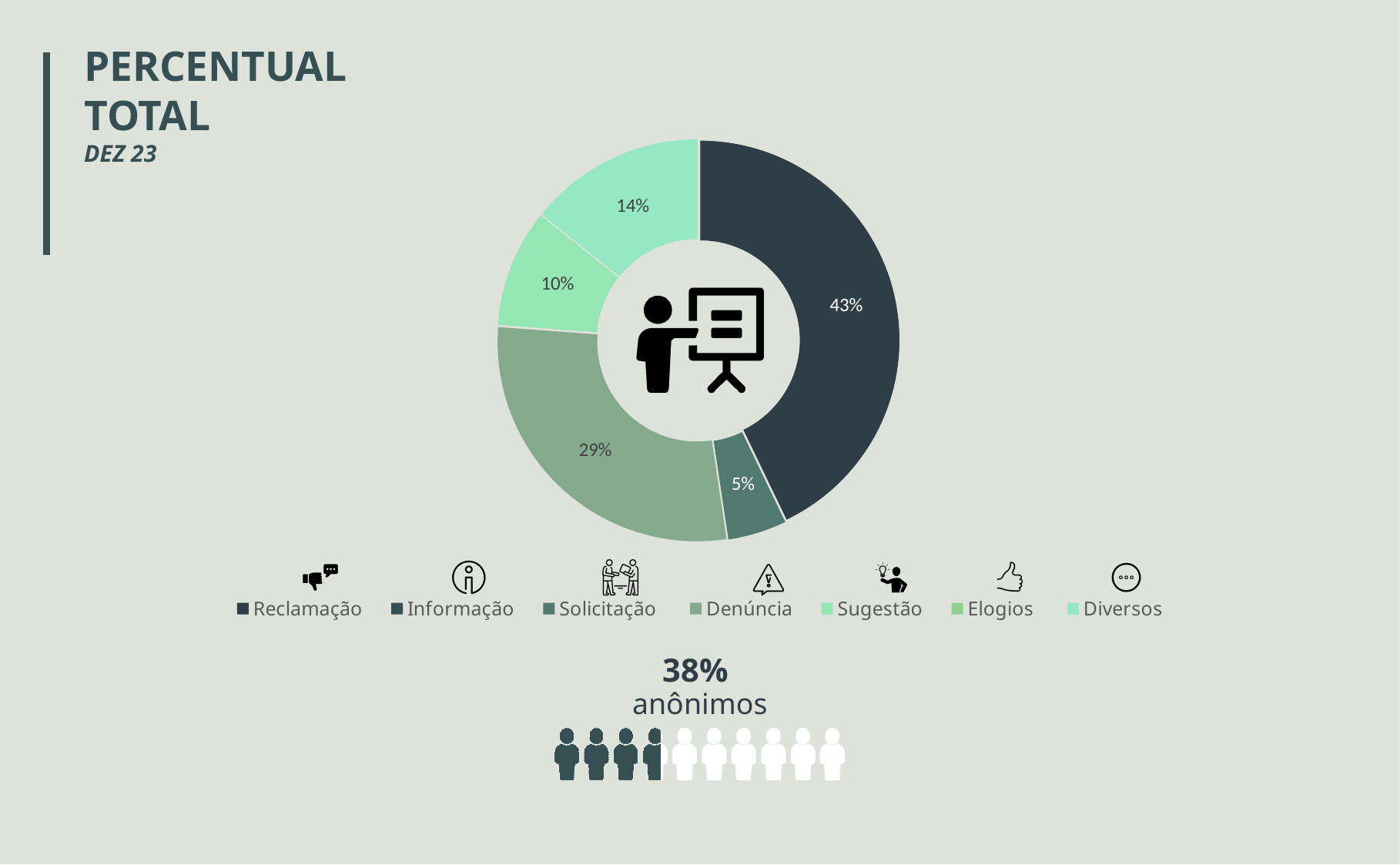
What percentage of contacts is reported as anonymous (anônimos) below the chart? 38% What is the smallest percentage shown on the chart? 5% How many entries does the legend list? 7 What is the share of the Solicitação slice? 5% What is the difference in percentage points between the largest slice (43%) and the Denúncia slice (29%)? 14 How many slices have a percentage label printed on the chart? 5 What kind of chart is shown on the slide? Pie chart (donut) Which month is indicated under the chart title? DEZ 23 Which is larger, the Denúncia slice or the slice labelled 14%? Denúncia What is the share of the Denúncia slice? 29% What is the title of the chart on the slide? PERCENTUAL TOTAL What is the largest percentage shown on the chart? 43%